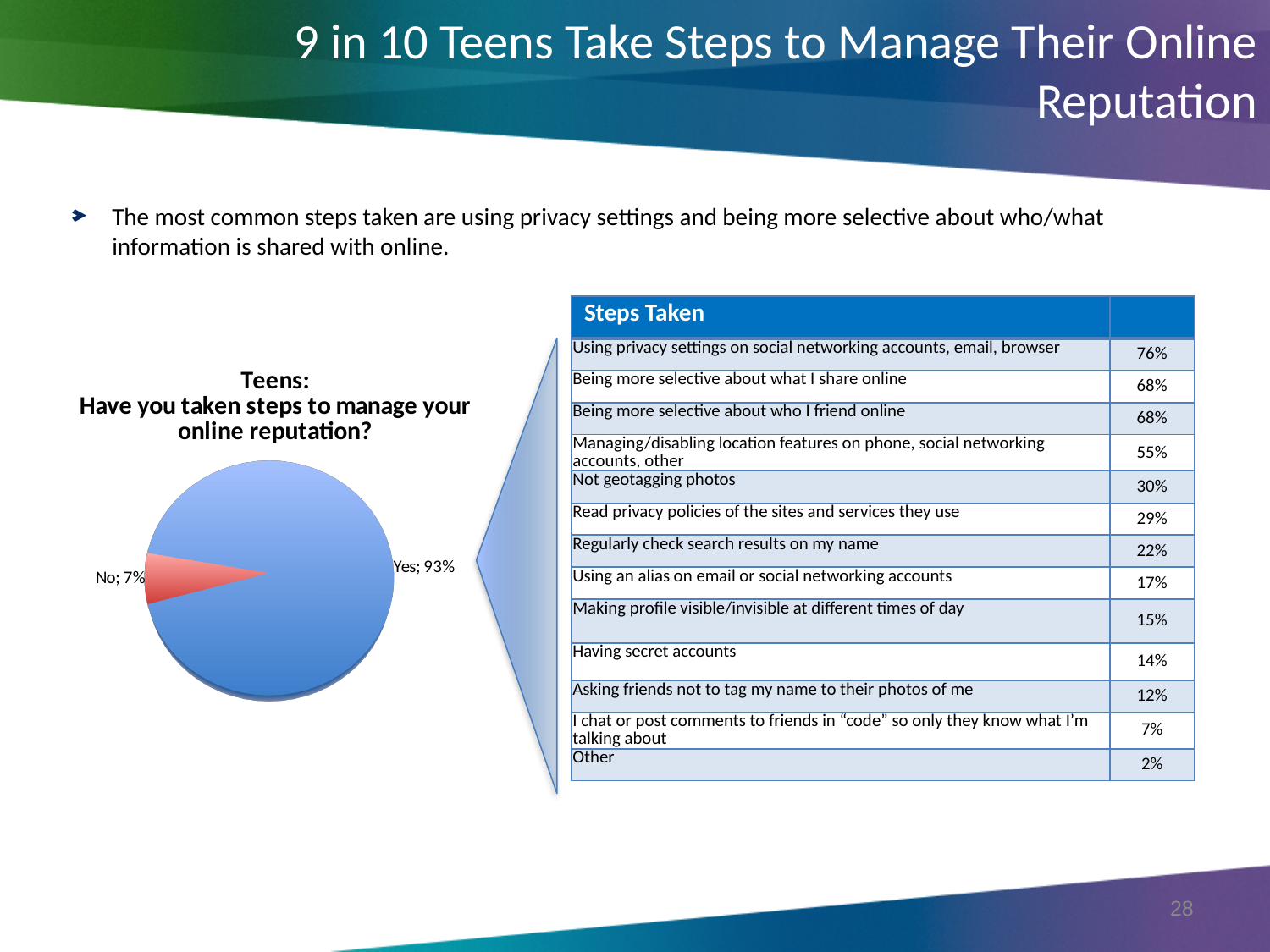
Which is larger in the pie chart, the "Yes" slice or the "No" slice? Yes Which slice of the pie chart is the largest? Yes How many slices does the pie chart have? 2 What is the difference in percentage points between the "Yes" and "No" slices? 86 What type of chart is shown on the slide? pie chart What percentage of teens answered "Yes" to having taken steps to manage their online reputation? 93% What percentage of teens answered "No" in the pie chart? 7% What is the title of the pie chart? Teens: Have you taken steps to manage your online reputation? Which slice of the pie chart is the smallest? No What share of the pie does the "No" slice represent? 7% What colour is the "No" slice in the pie chart? red